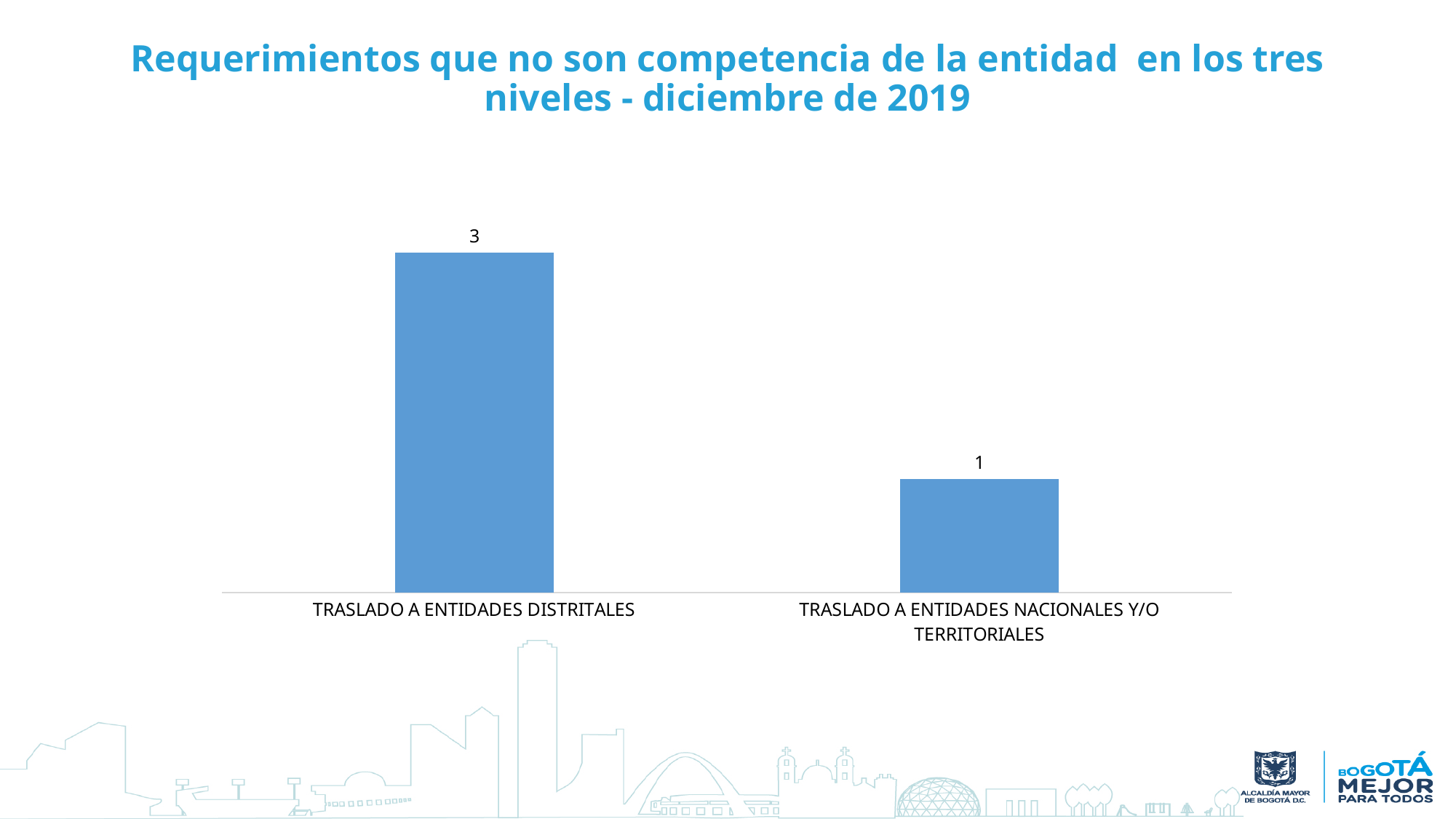
How many categories are shown in the chart? 2 Which category has the lowest value? TRASLADO A ENTIDADES NACIONALES Y/O TERRITORIALES Do the values rise or fall from left to right along the x axis? Fall What is the difference between the values for TRASLADO A ENTIDADES DISTRITALES and TRASLADO A ENTIDADES NACIONALES Y/O TERRITORIALES? 2 What colour are the bars in the chart? Blue What is the total of the two values shown in the chart? 4 What is the title of the slide? Requerimientos que no son competencia de la entidad en los tres niveles - diciembre de 2019 What is the value for TRASLADO A ENTIDADES NACIONALES Y/O TERRITORIALES? 1 What is the value for TRASLADO A ENTIDADES DISTRITALES? 3 Which category has the highest value? TRASLADO A ENTIDADES DISTRITALES Which is larger: the value for TRASLADO A ENTIDADES DISTRITALES or for TRASLADO A ENTIDADES NACIONALES Y/O TERRITORIALES? TRASLADO A ENTIDADES DISTRITALES What kind of chart is shown on the slide? Bar chart